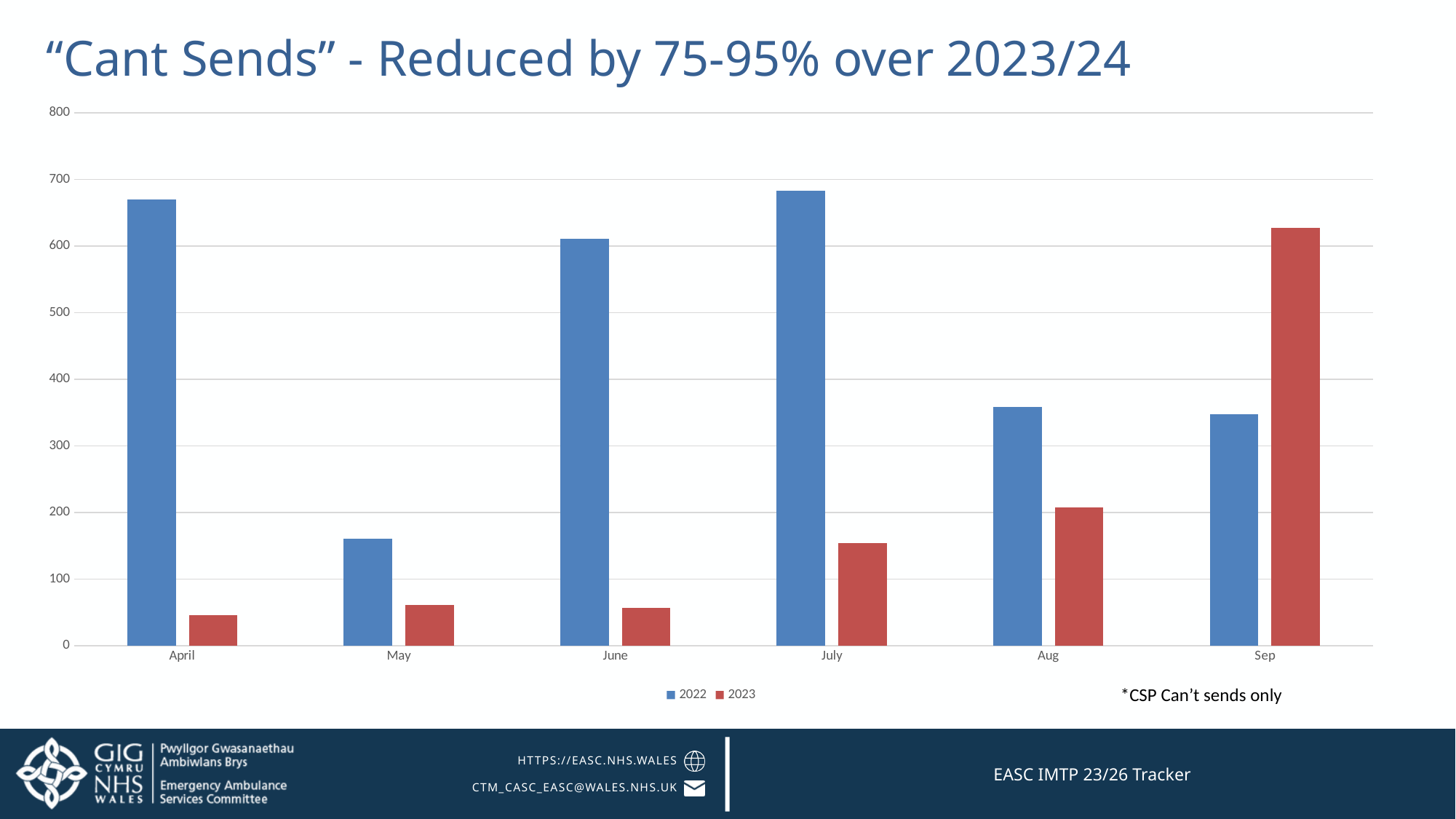
Is the 2022 value for April greater or less than 600? greater For Sep, which series has the larger value, 2022 or 2023? 2023 What are the two entries in the chart's legend? 2022 and 2023 How many series does the chart's legend list? 2 Is the 2023 value for June greater or less than 100? less What kind of chart is shown on the slide? bar chart Is the 2023 value for Sep greater or less than 600? greater For April, which series has the larger value, 2022 or 2023? 2022 How many months are shown on the x axis of the chart? 6 Which month has the highest value for the 2023 series? Sep Which month has the lowest value for the 2022 series? May